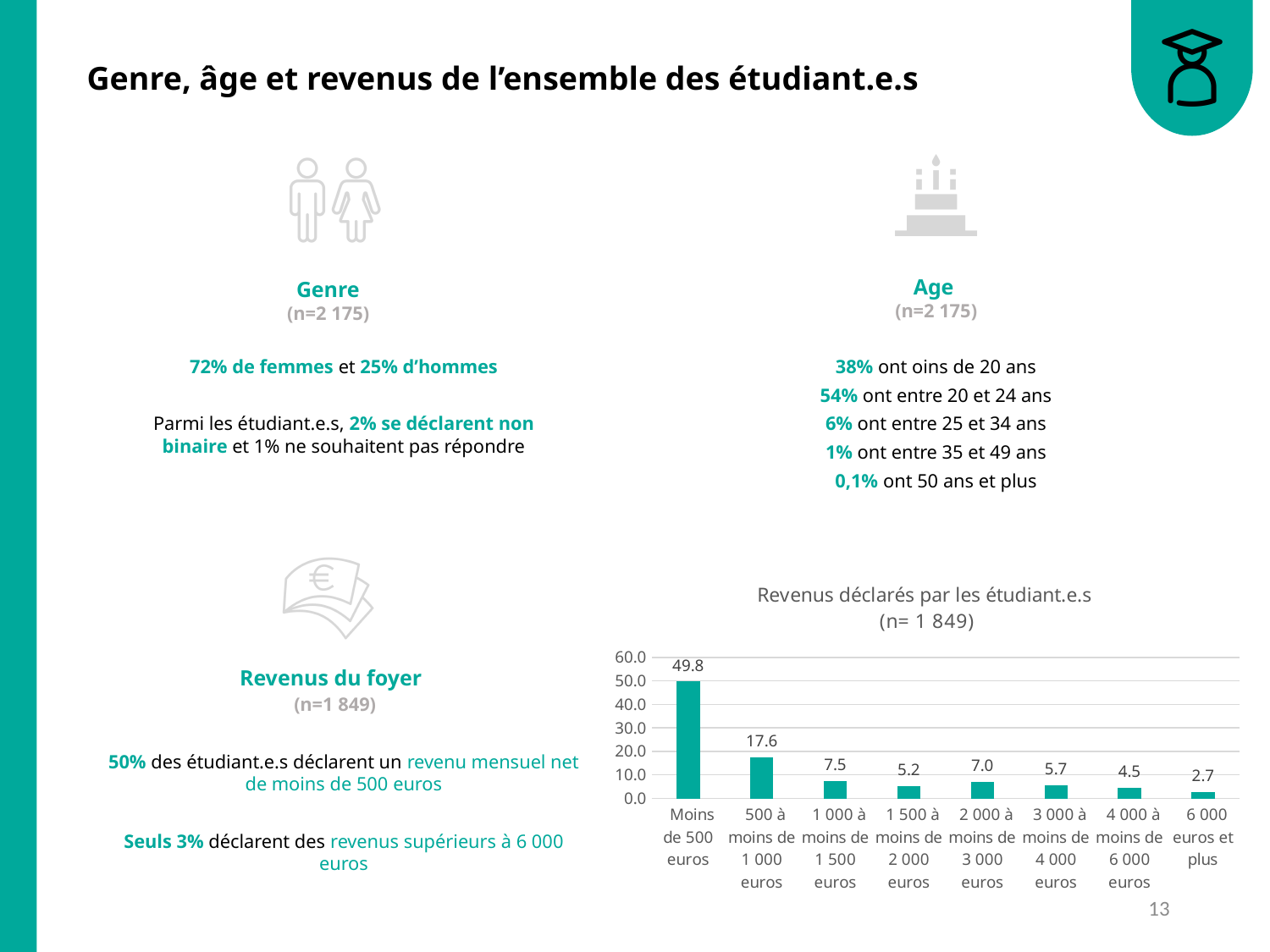
Which is larger: the value for '1 000 à moins de 1 500 euros' or the value for '1 500 à moins de 2 000 euros'? 1 000 à moins de 1 500 euros Which category has the highest value in the 'Revenus déclarés par les étudiant.e.s' chart? Moins de 500 euros What is the difference between the values for 'Moins de 500 euros' and '500 à moins de 1 000 euros'? 32.2 What is the title of the chart on the slide? Revenus déclarés par les étudiant.e.s (n= 1 849) What is the value for the '500 à moins de 1 000 euros' category in the chart? 17.6 What kind of chart is 'Revenus déclarés par les étudiant.e.s'? bar chart How many categories are shown on the x axis of the chart? 8 Is the value for '500 à moins de 1 000 euros' greater or less than 20.0? less Which category has the lowest value in the chart? 6 000 euros et plus What is the value for the '6 000 euros et plus' category in the chart? 2.7 What is the value for the 'Moins de 500 euros' category in the 'Revenus déclarés par les étudiant.e.s' chart? 49.8 What is the value for the '2 000 à moins de 3 000 euros' category in the chart? 7.0